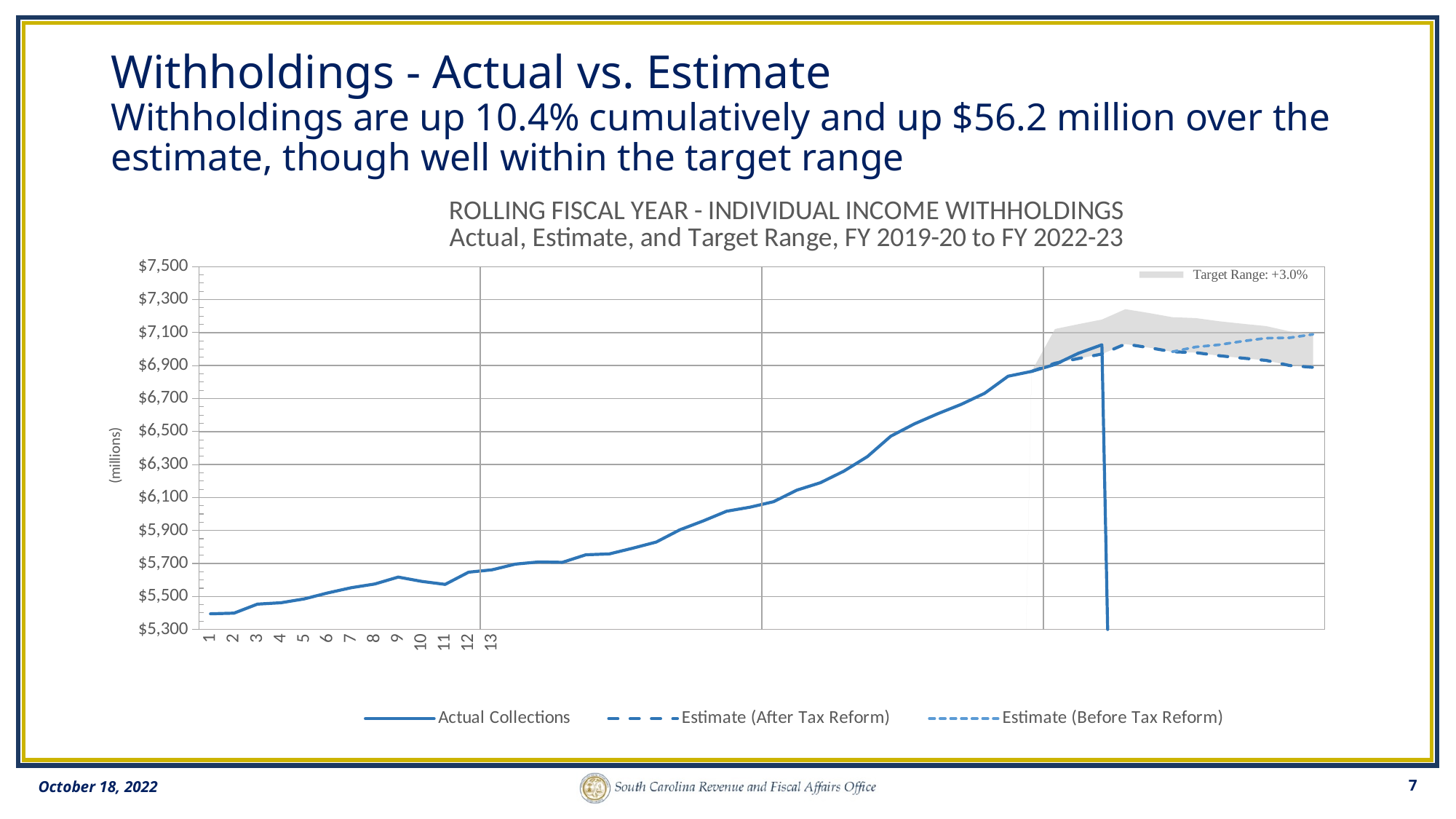
What kind of chart is shown on the slide? Line chart What unit is shown on the vertical axis label? millions Is the value for Actual Collections at point 1 greater or less than $5,500? less Is the final value of the Estimate (Before Tax Reform) line greater or less than $6,900? greater Is the value for Actual Collections at point 13 greater or less than $5,700? less Does the Actual Collections line generally rise or fall from point 1 to its peak near the right of the chart? Rise How many series does the legend at the bottom of the chart list? 3 What is the title of the chart? ROLLING FISCAL YEAR - INDIVIDUAL INCOME WITHHOLDINGS Actual, Estimate, and Target Range, FY 2019-20 to FY 2022-23 At the right end of the chart, which is higher: Estimate (Before Tax Reform) or Estimate (After Tax Reform)? Estimate (Before Tax Reform)